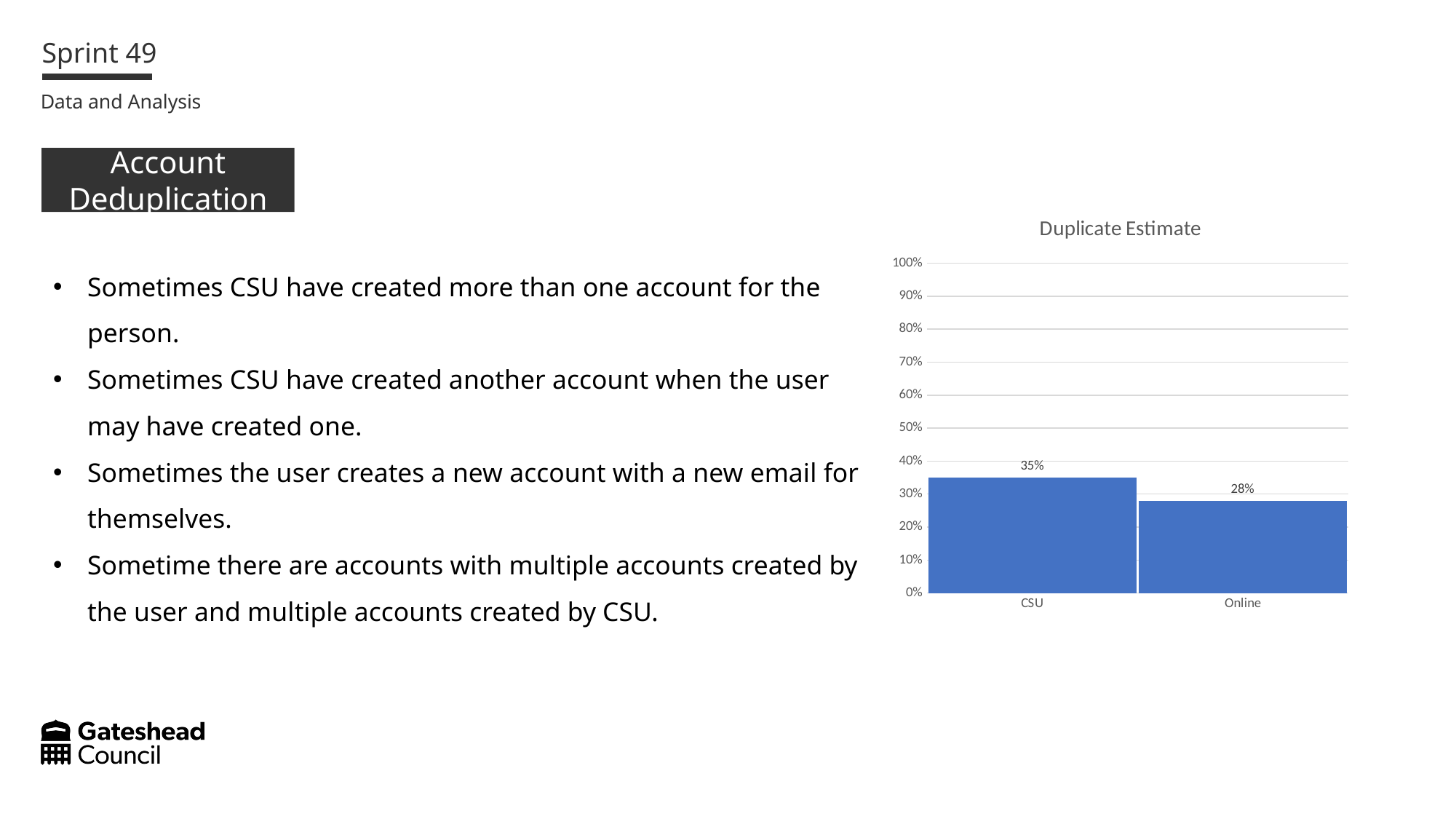
What is the duplicate estimate for CSU? 35% What is the title of the chart? Duplicate Estimate Is the value for CSU greater or less than 30%? greater What is the maximum value shown on the chart's vertical axis? 100% What kind of chart is shown on the slide? bar chart Which category has the lower duplicate estimate? Online What is the duplicate estimate for Online? 28% Is the value for Online greater or less than 30%? less Is the duplicate estimate for CSU larger or smaller than the estimate for Online? larger Which category has the higher duplicate estimate? CSU How many categories are shown on the chart? 2 What is the difference between the CSU and Online duplicate estimates? 7%